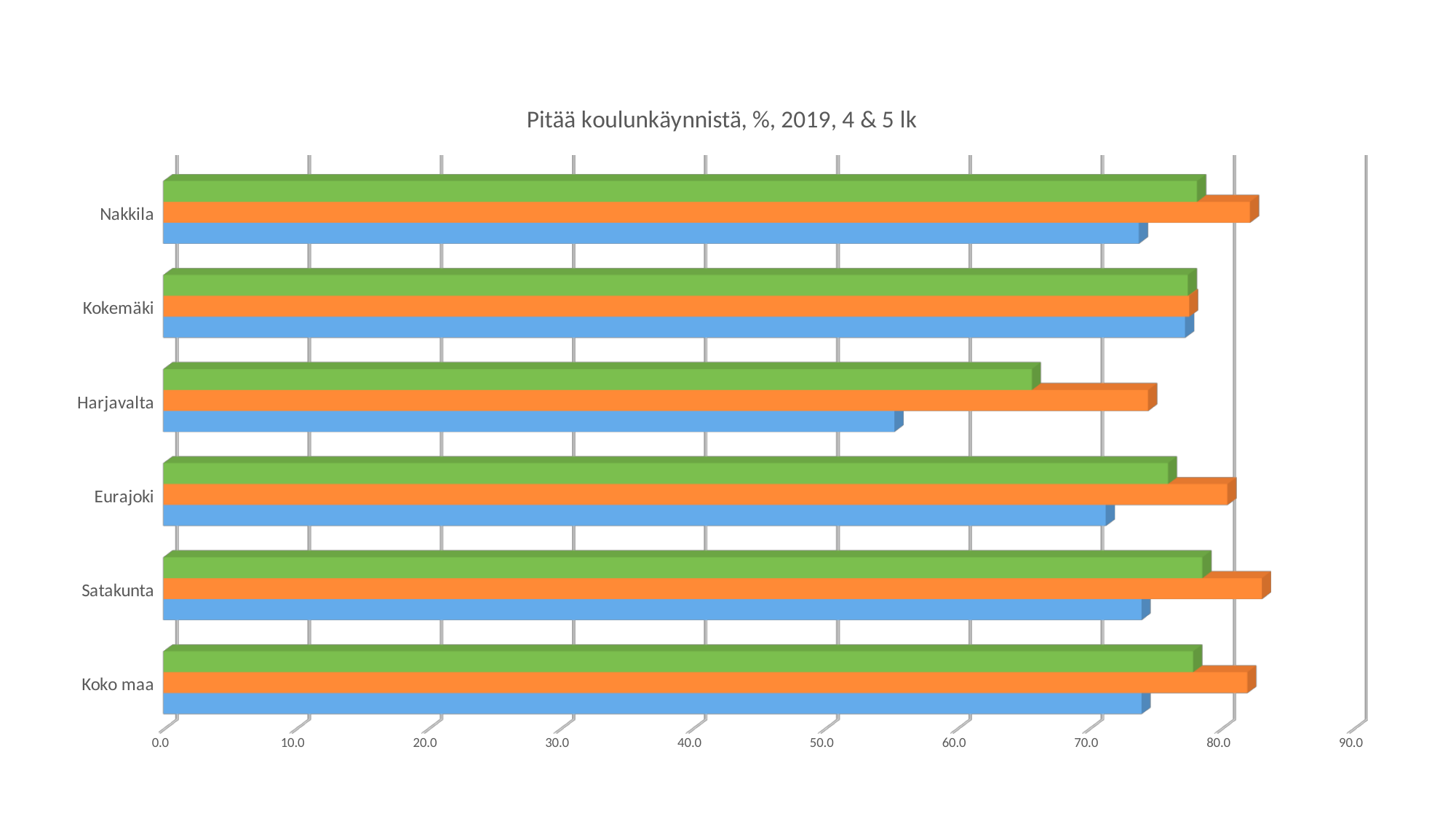
Is the value of the green bar for Harjavalta greater or less than 60.0? greater Is the value of the orange bar for Harjavalta greater or less than 70.0? greater Is the value of the orange bar for Nakkila greater or less than 80.0? greater Which category has the lowest orange bar? Harjavalta For Harjavalta, which is larger: the orange bar or the blue bar? the orange bar Which category has the lowest blue bar? Harjavalta What kind of chart is shown on the slide? bar chart How many bars are plotted for each category in the chart? 3 How many categories are shown on the vertical axis of the chart? 6 What is the title of the chart? Pitää koulunkäynnistä, %, 2019, 4 & 5 lk